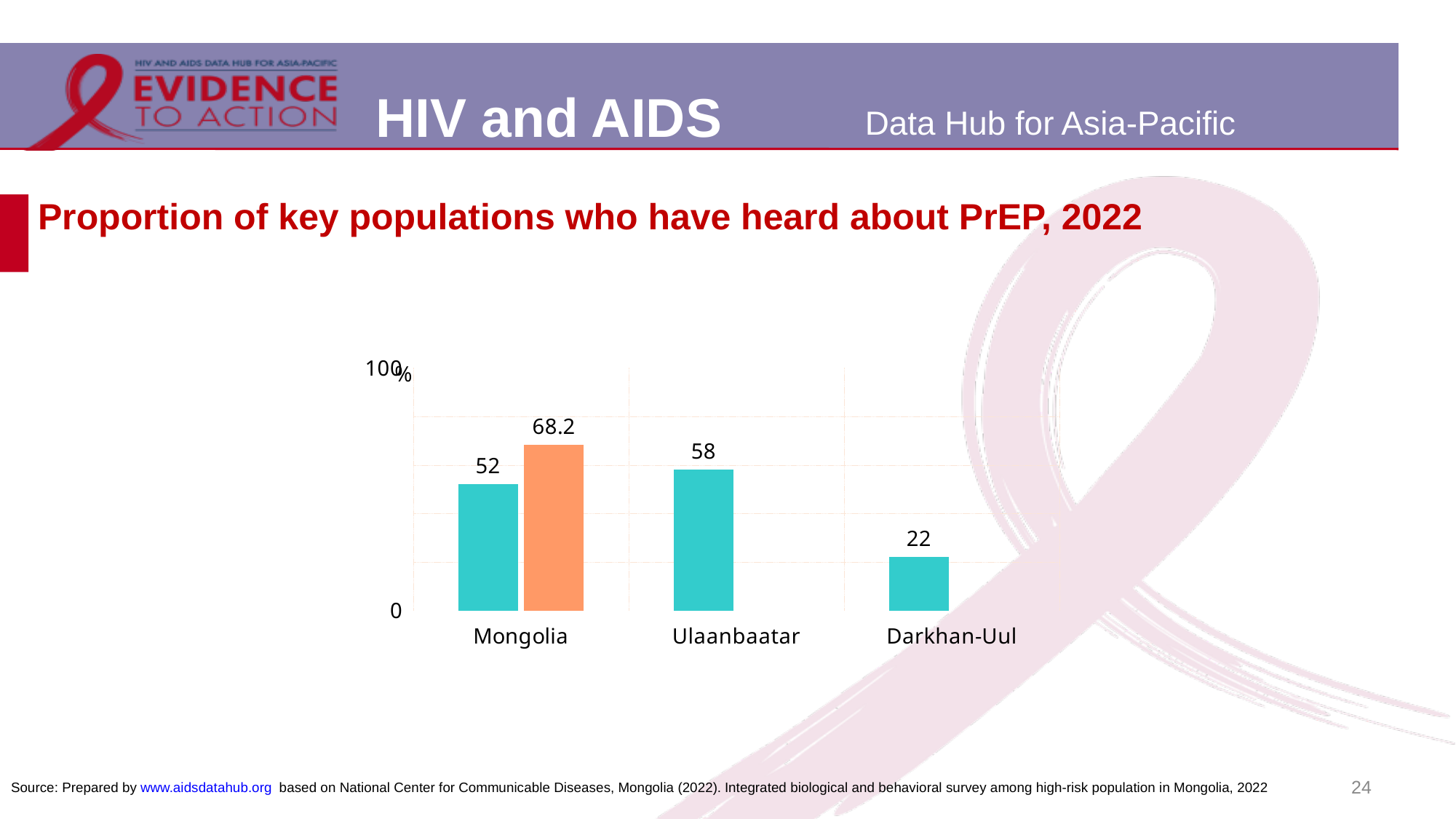
What is the difference between the values for Ulaanbaatar and Darkhan-Uul? 36 Which category has the highest teal bar? Ulaanbaatar What is the value of the teal bar for Mongolia? 52 What is the title of the chart on the slide? Proportion of key populations who have heard about PrEP, 2022 What kind of chart is shown on the slide? bar chart How many categories are shown on the x axis of the chart? 3 What is the difference between the orange bar and the teal bar for Mongolia? 16.2 Which is larger: the teal bar for Mongolia or the bar for Ulaanbaatar? Ulaanbaatar What is the value shown for Ulaanbaatar? 58 Which category has the lowest value in the chart? Darkhan-Uul What is the value shown for Darkhan-Uul? 22 What is the value of the orange bar for Mongolia? 68.2